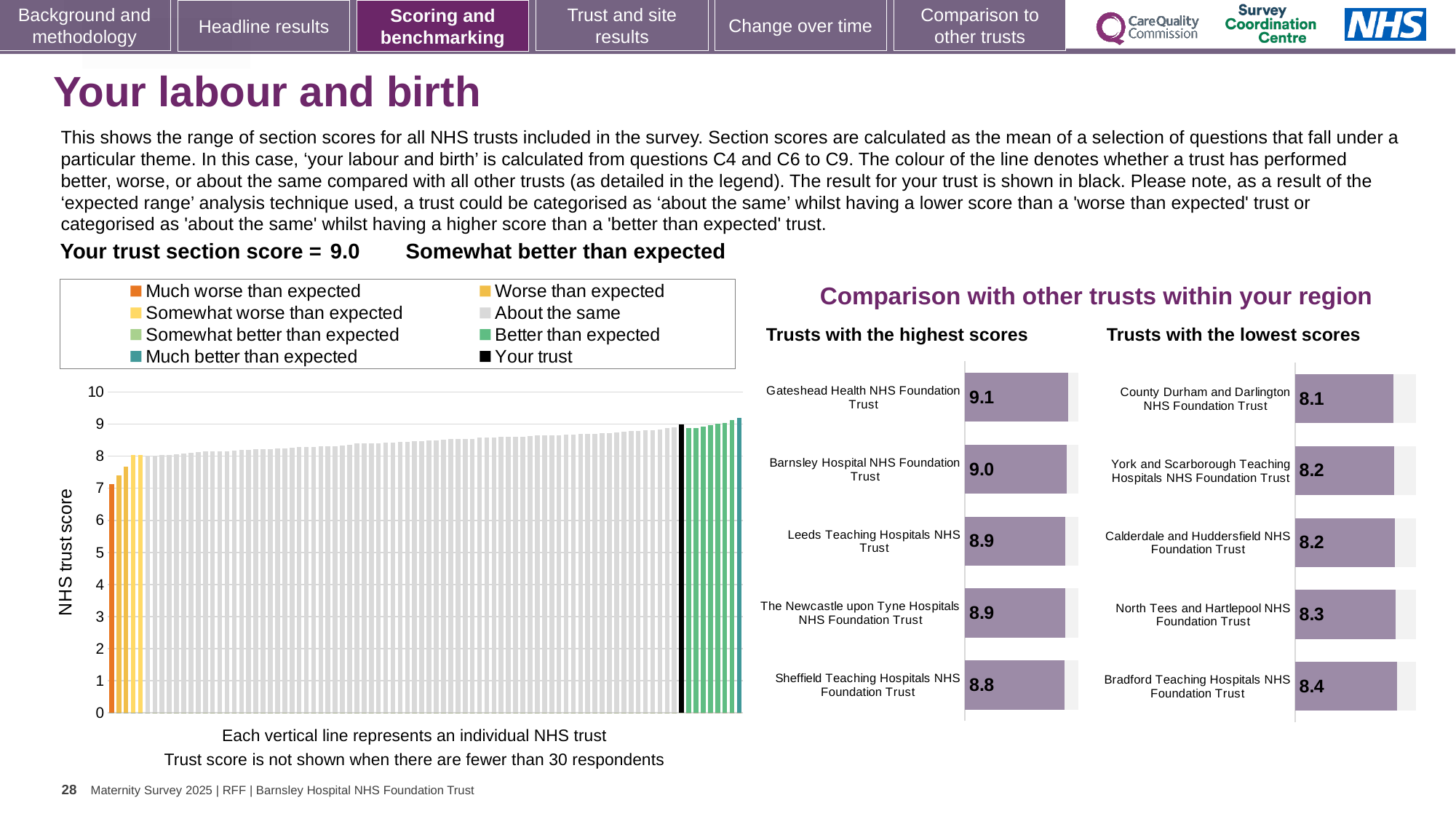
In the 'Trusts with the highest scores' chart, what is the score for Sheffield Teaching Hospitals NHS Foundation Trust? 8.8 How many trusts are shown in the 'Trusts with the lowest scores' chart? 5 In the 'Trusts with the highest scores' chart, what is the difference between the scores of Gateshead Health NHS Foundation Trust and Sheffield Teaching Hospitals NHS Foundation Trust? 0.3 In the 'Trusts with the highest scores' chart, which trust has the highest score? Gateshead Health NHS Foundation Trust Which is larger: the score for Barnsley Hospital NHS Foundation Trust in the 'Trusts with the highest scores' chart or the score for North Tees and Hartlepool NHS Foundation Trust in the 'Trusts with the lowest scores' chart? Barnsley Hospital NHS Foundation Trust In the main 'NHS trust score' chart, do the bar values rise or fall from left to right? rise How many entries does the legend of the main 'NHS trust score' chart list? 8 In the 'Trusts with the highest scores' chart, what is the score for Gateshead Health NHS Foundation Trust? 9.1 In the 'Trusts with the lowest scores' chart, what is the difference between the scores of Bradford Teaching Hospitals NHS Foundation Trust and County Durham and Darlington NHS Foundation Trust? 0.3 In the 'Trusts with the lowest scores' chart, what is the score for County Durham and Darlington NHS Foundation Trust? 8.1 In the 'Trusts with the lowest scores' chart, what is the score for Bradford Teaching Hospitals NHS Foundation Trust? 8.4 In the 'Trusts with the lowest scores' chart, which trust has the lowest score? County Durham and Darlington NHS Foundation Trust